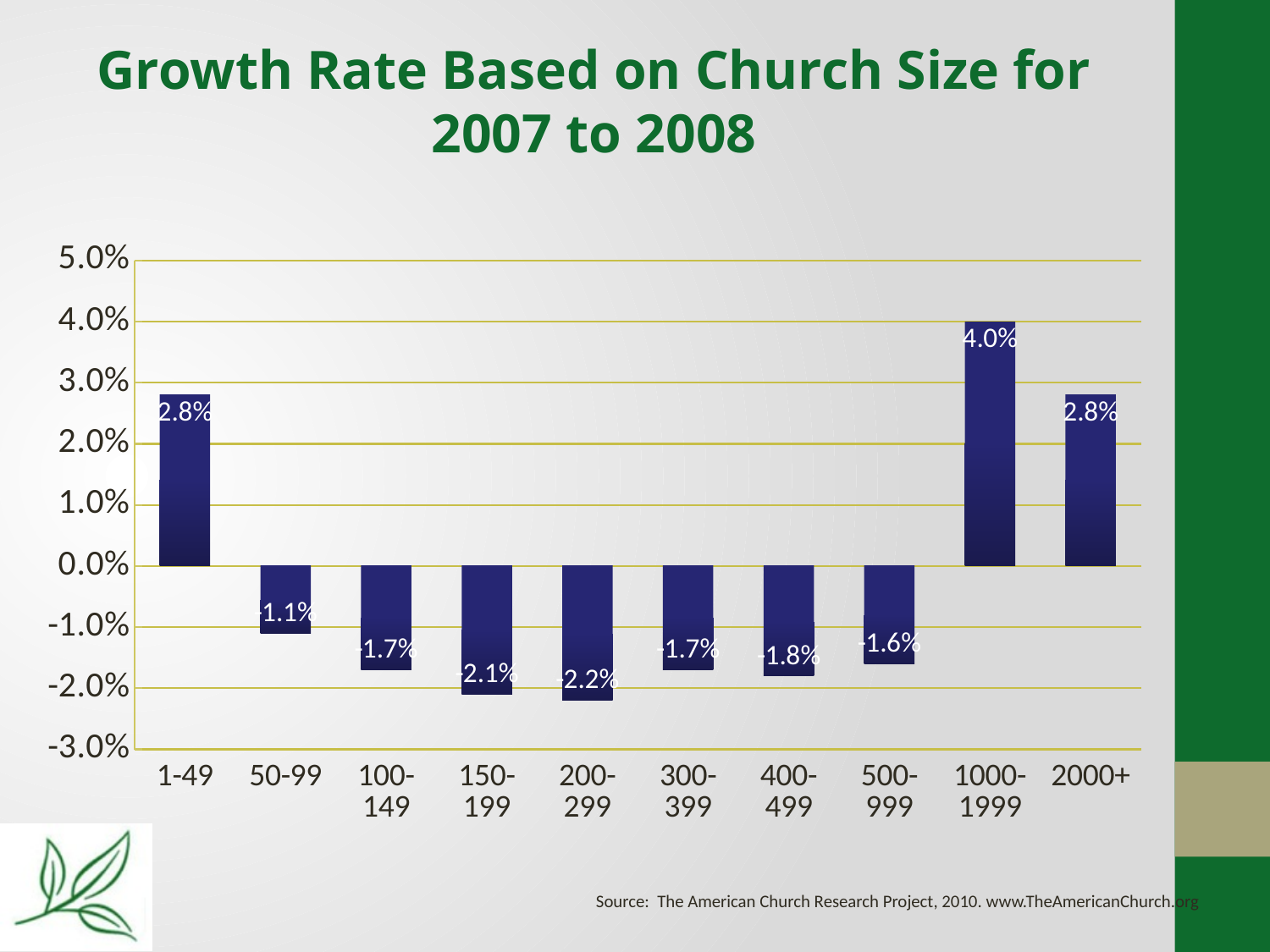
What is the growth rate for churches of size 200-299? -2.2% What is the title of the chart? Growth Rate Based on Church Size for 2007 to 2008 Is the growth rate for churches of size 1000-1999 greater or less than 3.0%? greater What is the difference between the growth rate for 1000-1999 and the growth rate for 2000+? 1.2% What is the growth rate for churches of size 2000+? 2.8% Which church size category has the highest growth rate? 1000-1999 Which church size category has the lowest growth rate? 200-299 How many church size categories are shown on the x axis? 10 What is the growth rate for churches of size 1000-1999? 4.0% Which has the higher growth rate, churches of size 50-99 or churches of size 150-199? 50-99 What is the growth rate for churches of size 50-99? -1.1% What kind of chart is shown on the slide? bar chart